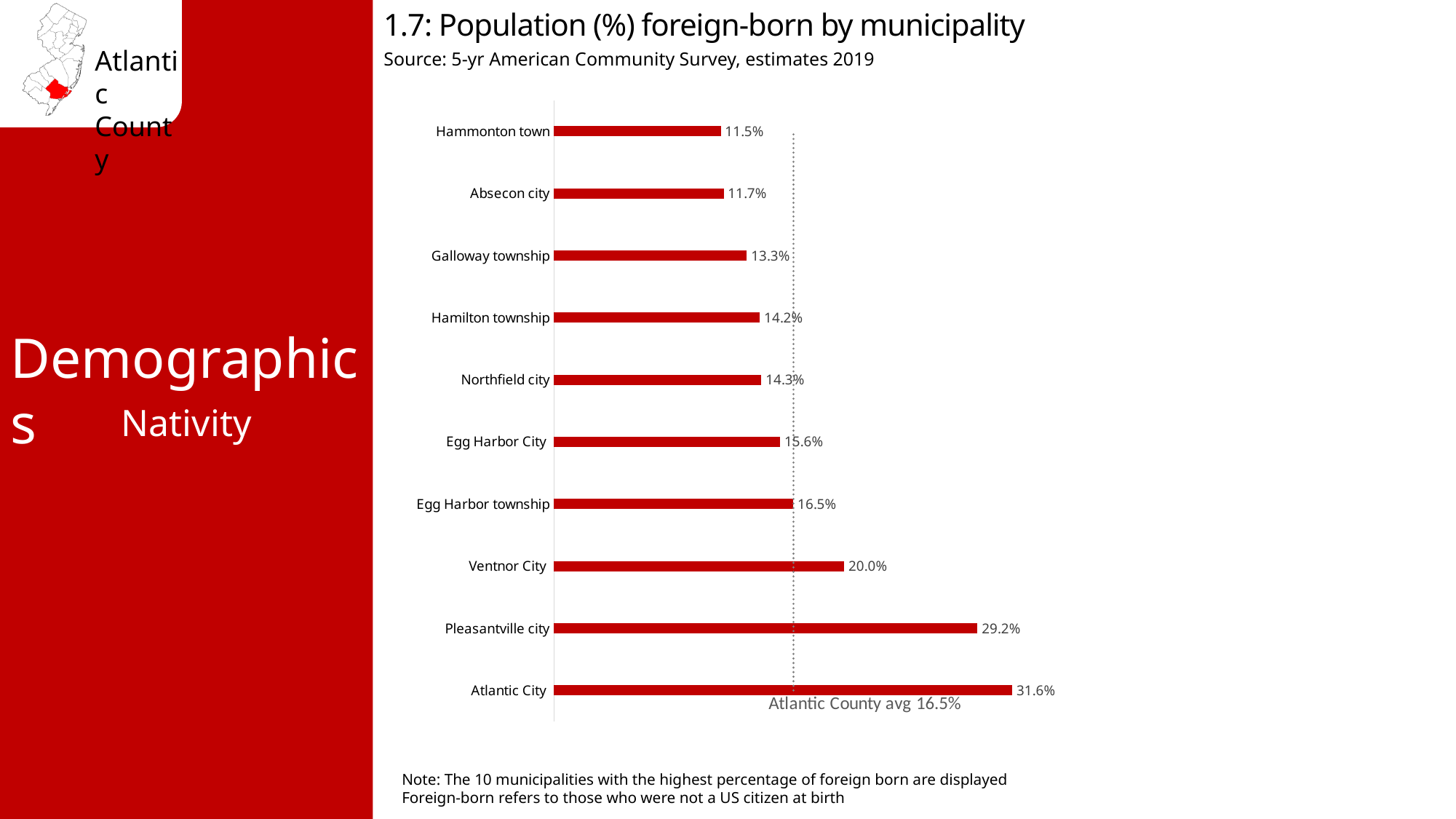
Which has a higher foreign-born percentage, Pleasantville city or Ventnor City? Pleasantville city What is the difference in foreign-born percentage between Atlantic City and Pleasantville city? 2.4% How many municipalities are shown in the chart? 10 What is the Atlantic County average foreign-born percentage marked by the dotted line? 16.5% What is the foreign-born population percentage for Ventnor City? 20.0% Which has a higher foreign-born percentage, Absecon city or Egg Harbor City? Egg Harbor City What type of chart is used to show the foreign-born population by municipality? Bar chart Which municipality has the highest percentage of foreign-born population? Atlantic City Which municipality has the lowest percentage of foreign-born population? Hammonton town What is the difference in foreign-born percentage between Ventnor City and Egg Harbor township? 3.5% What is the foreign-born population percentage for Atlantic City? 31.6% What is the foreign-born population percentage for Galloway township? 13.3%